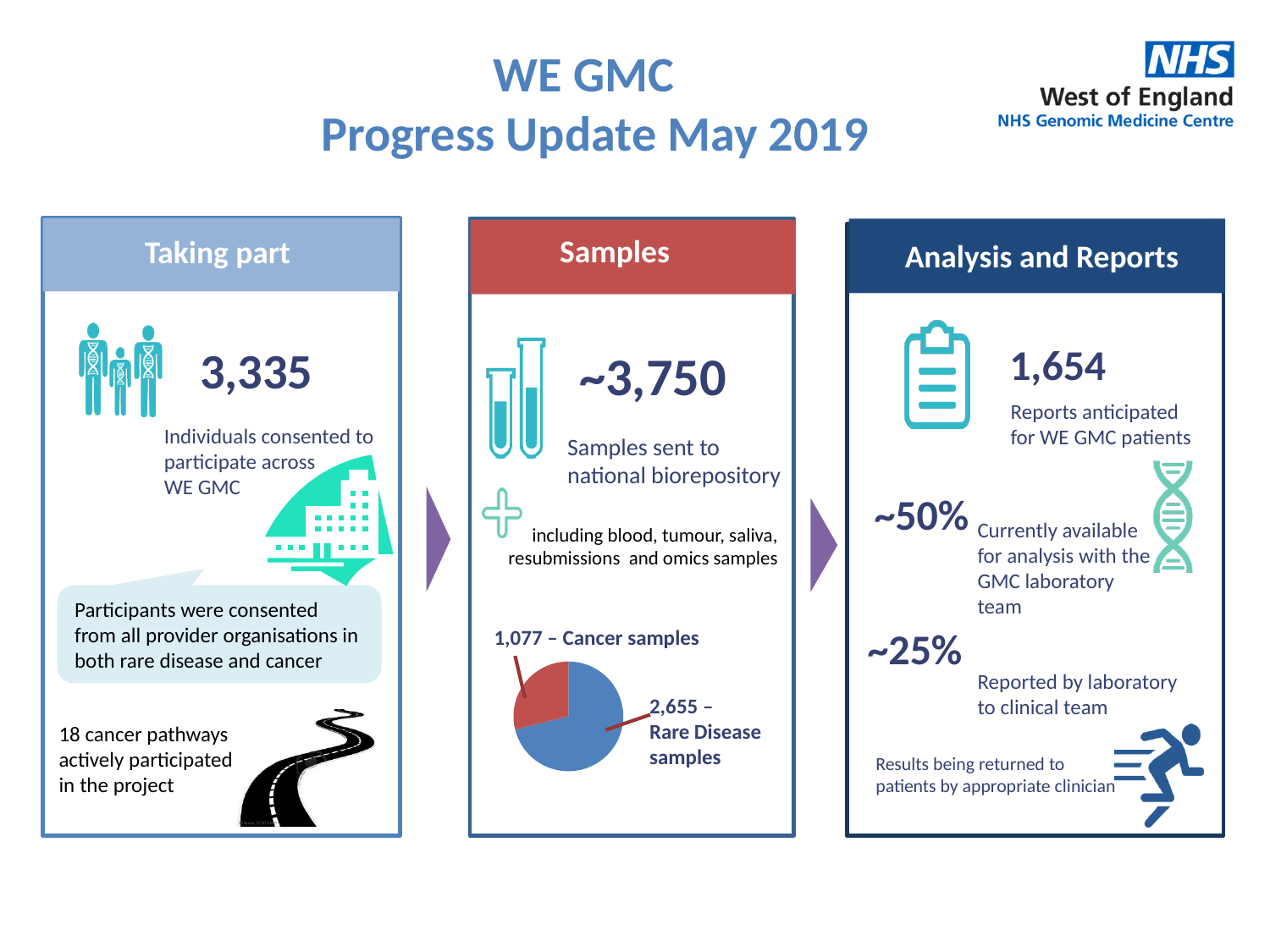
Which slice of the pie chart is larger, Cancer samples or Rare Disease samples? Rare Disease samples Which category has the smallest slice in the pie chart? Cancer samples Which category has the largest slice in the pie chart? Rare Disease samples What is the difference between the number of Rare Disease samples and Cancer samples in the pie chart? 1,578 What colour is the Cancer samples slice in the pie chart? red What kind of chart is shown in the Samples panel? pie chart In the pie chart, how many Cancer samples are shown? 1,077 What colour is the Rare Disease samples slice in the pie chart? blue How many slices does the pie chart have? 2 What is the total of the two slices in the pie chart? 3,732 In the pie chart, how many Rare Disease samples are shown? 2,655